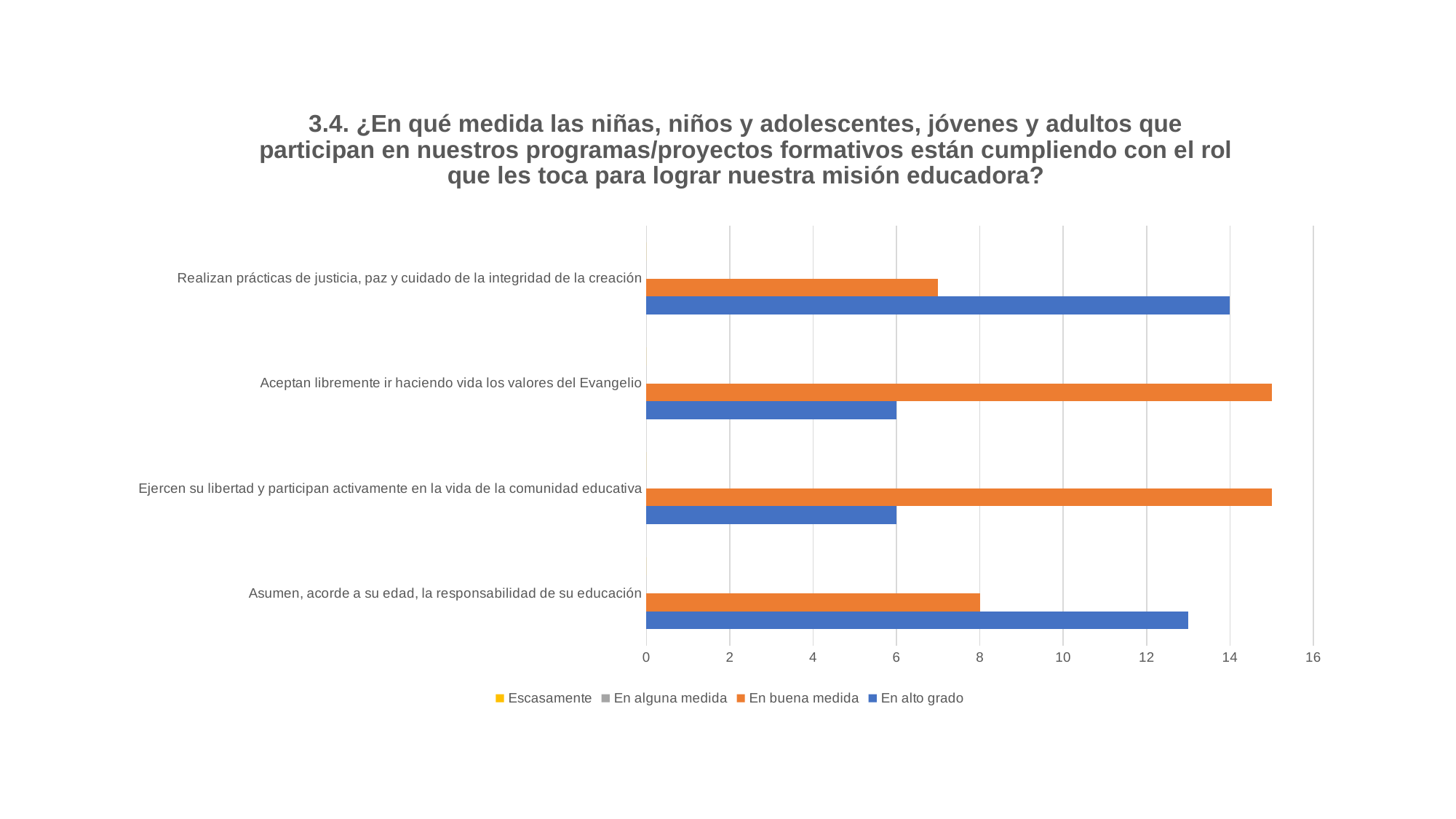
Which category has the highest value for 'En alto grado'? Realizan prácticas de justicia, paz y cuidado de la integridad de la creación Is the value of 'En alto grado' for 'Asumen, acorde a su edad, la responsabilidad de su educación' greater or less than 12? greater How many series does the legend list? 4 For 'Realizan prácticas de justicia, paz y cuidado de la integridad de la creación', which is larger: 'En alto grado' or 'En buena medida'? En alto grado How many categories are plotted on the chart? 4 What kind of chart is shown on the slide? bar chart What is the value of 'En alto grado' for 'Aceptan libremente ir haciendo vida los valores del Evangelio'? 6 Is the value of 'En buena medida' for 'Aceptan libremente ir haciendo vida los valores del Evangelio' greater or less than 14? greater What is the difference between the 'En alto grado' values for 'Realizan prácticas de justicia, paz y cuidado de la integridad de la creación' and 'Aceptan libremente ir haciendo vida los valores del Evangelio'? 8 What is the value of 'En alto grado' for 'Realizan prácticas de justicia, paz y cuidado de la integridad de la creación'? 14 What is the value of 'En buena medida' for 'Asumen, acorde a su edad, la responsabilidad de su educación'? 8 What colour represents the 'En alto grado' series in the legend? blue